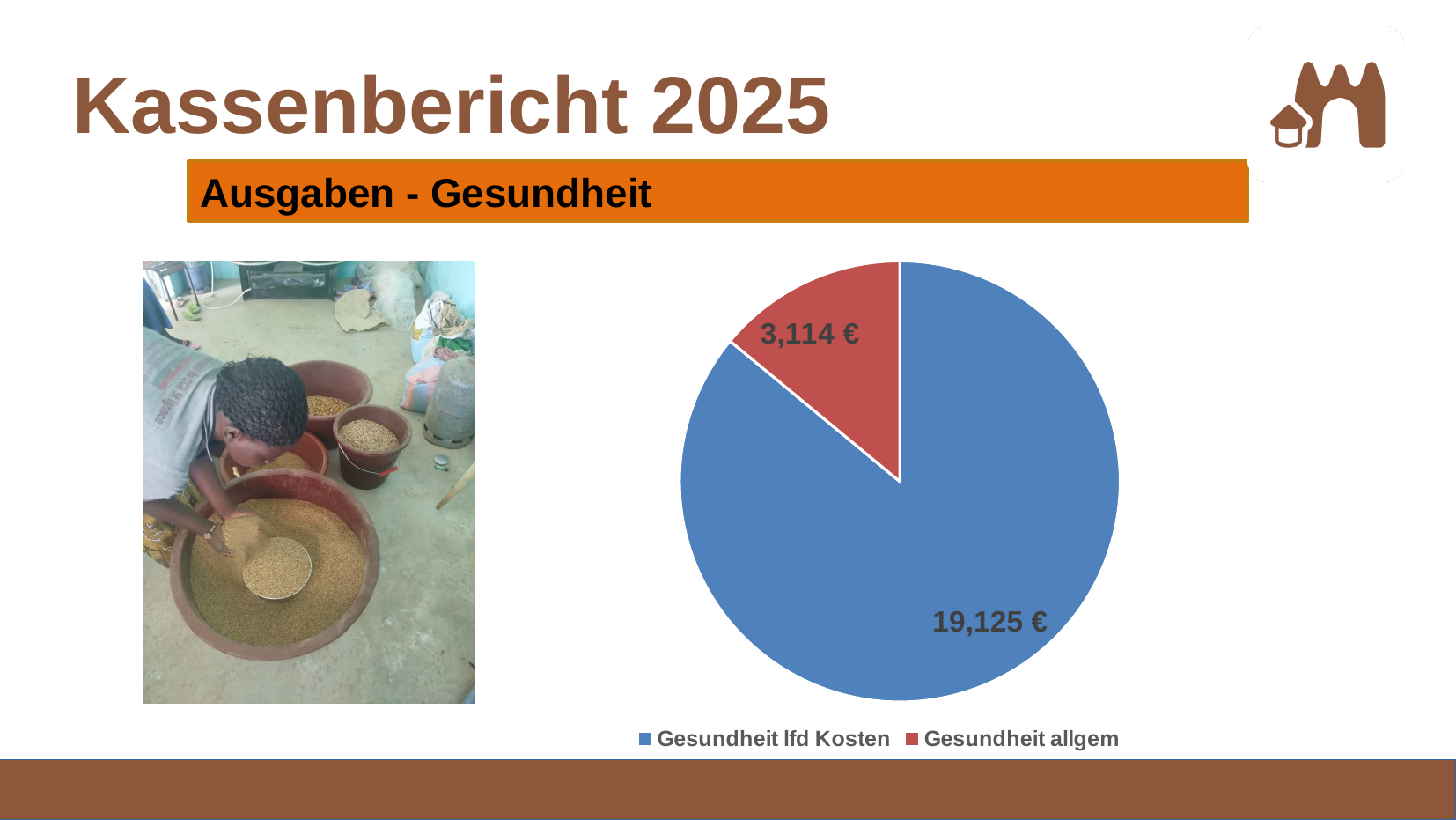
Which category has the smallest slice of the pie? Gesundheit allgem What is the difference between Gesundheit lfd Kosten and Gesundheit allgem? 16,011 € What colour is the slice for Gesundheit lfd Kosten? blue How many entries does the legend list? 2 What is the value for Gesundheit allgem? 3,114 € What share of the pie does Gesundheit allgem represent? 14% Which is larger, Gesundheit lfd Kosten or Gesundheit allgem? Gesundheit lfd Kosten What kind of chart is shown on the slide? pie chart What is the value for Gesundheit lfd Kosten? 19,125 € How many slices does the pie chart have? 2 Which category has the largest slice of the pie? Gesundheit lfd Kosten What is the total of all slices in the pie chart? 22,239 €